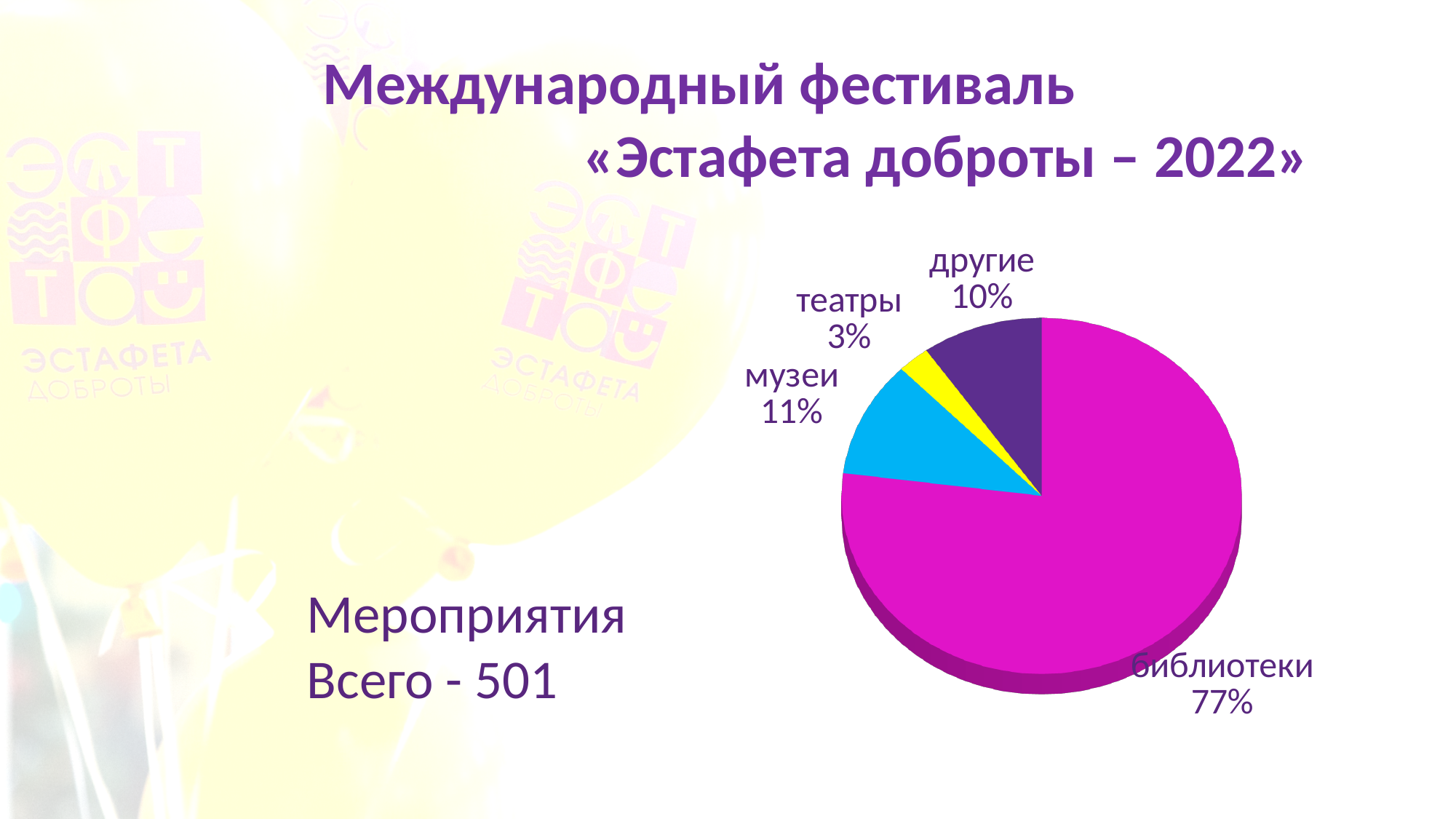
What share of the pie does другие have? 10% What kind of chart is shown on the slide? pie chart What is the difference in percentage points between библиотеки and музеи? 66 What share of the pie does театры have? 3% What share of the pie does библиотеки have? 77% How many categories are shown in the pie chart? 4 What colour is the slice for музеи? blue Which category has the largest slice of the pie? библиотеки Which category has the smallest slice of the pie? театры Which is larger, the share for музеи or the share for театры? музеи What is the difference in percentage points between музеи and другие? 1